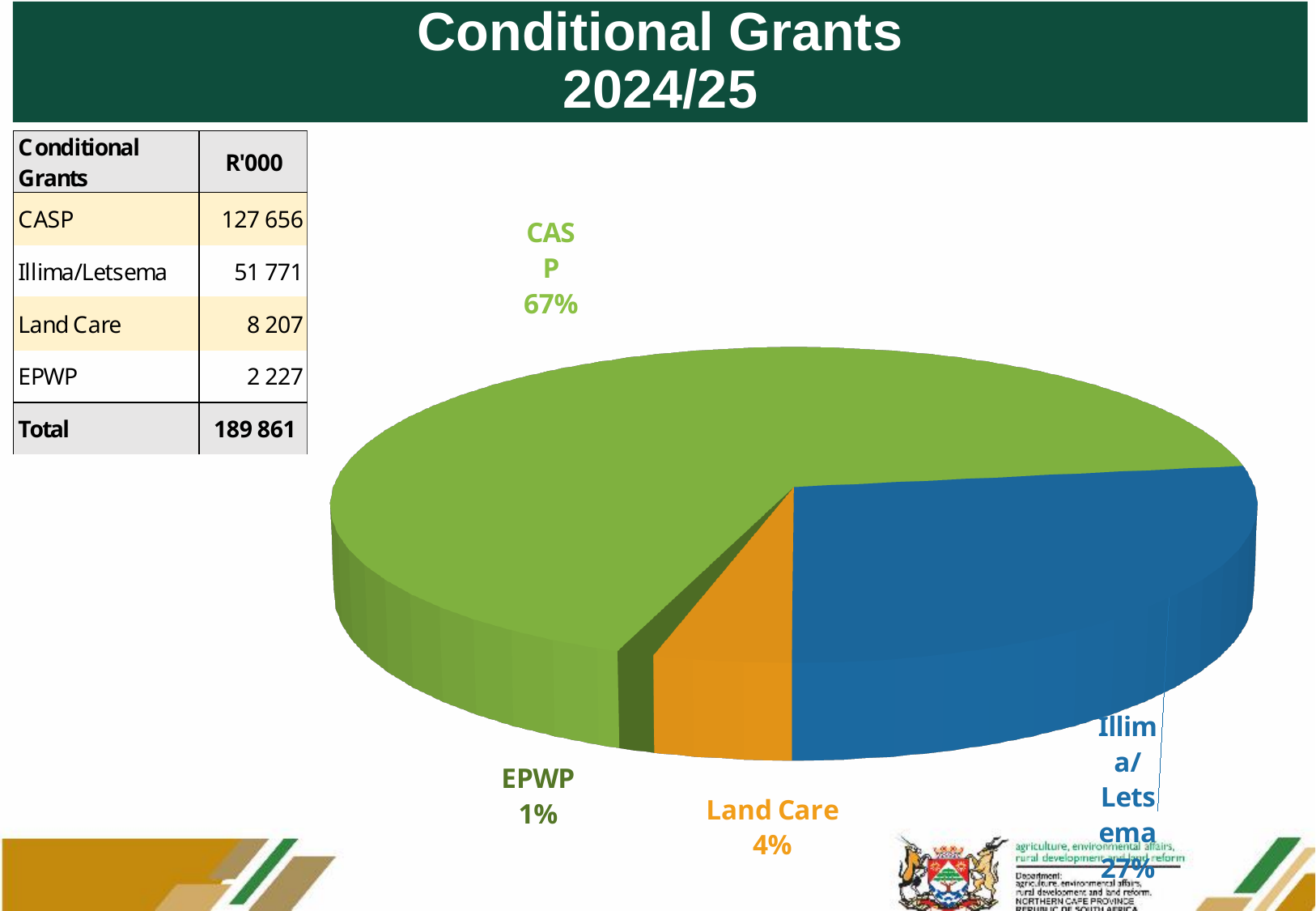
Which slice of the pie chart is the largest? CASP What is the difference in percentage points between the CASP share and the Illima/Letsema share in the pie chart? 40 What percentage share does Illima/Letsema have in the pie chart? 27% Which slice of the pie chart is the smallest? EPWP How many slices does the pie chart have? 4 What percentage share does Land Care have in the pie chart? 4% What percentage share does CASP have in the pie chart? 67% What kind of chart is shown on the slide? pie chart What colour is the Land Care slice in the pie chart? orange Which has a larger share in the pie chart, Land Care or Illima/Letsema? Illima/Letsema What colour is the Illima/Letsema slice in the pie chart? blue